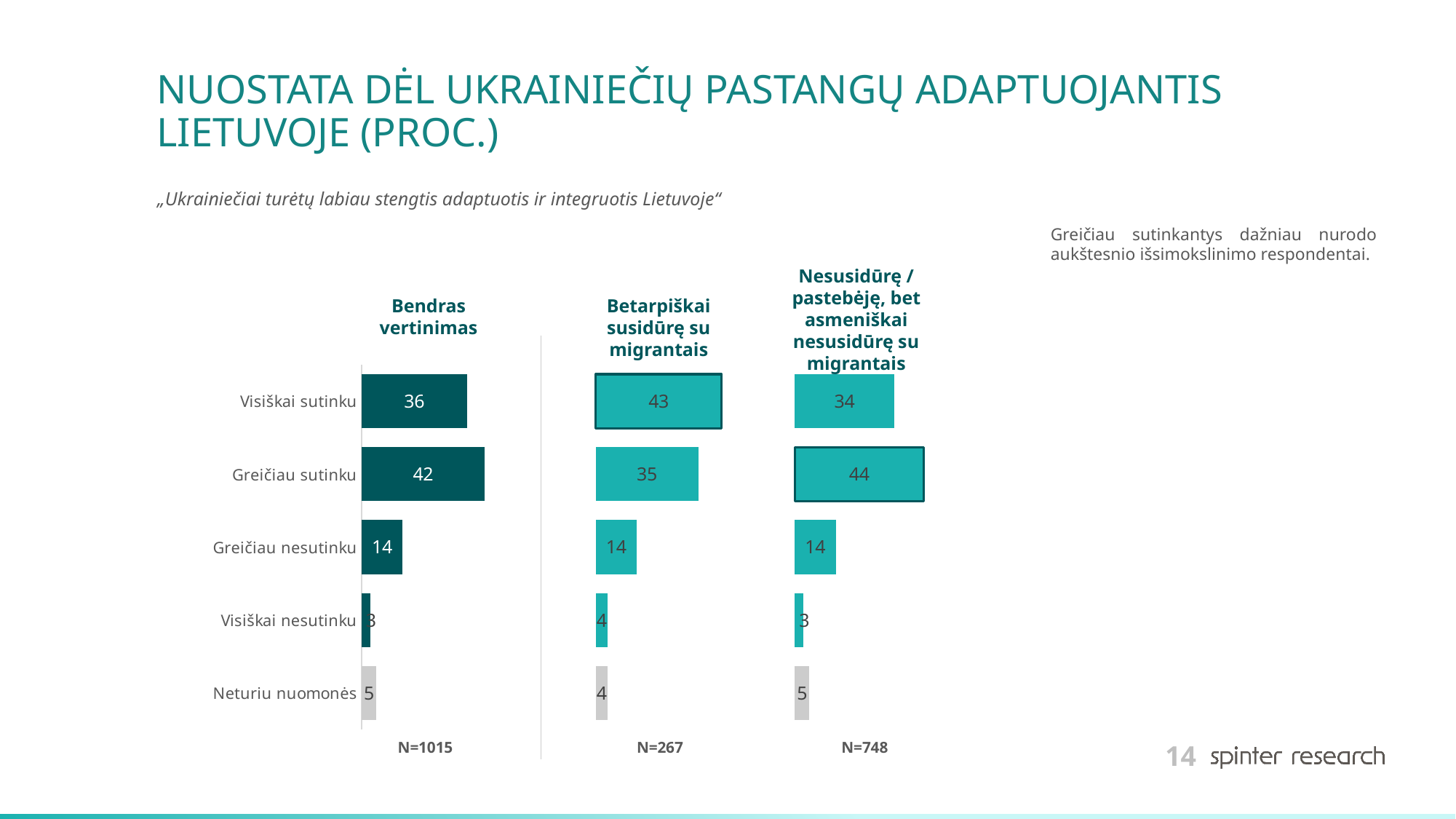
What is the sample size (N) shown under the "Betarpiškai susidūrę su migrantais" chart? N=267 Which is larger: "Visiškai sutinku" in the "Betarpiškai susidūrę su migrantais" chart or "Visiškai sutinku" in the "Nesusidūrę / pastebėję, bet asmeniškai nesusidūrę su migrantais" chart? Betarpiškai susidūrę su migrantais In the "Bendras vertinimas" chart, which category has the lowest value? Visiškai nesutinku In the "Nesusidūrę / pastebėję, bet asmeniškai nesusidūrę su migrantais" chart, what is the value for "Greičiau sutinku"? 44 In the "Bendras vertinimas" chart, what is the difference between "Greičiau sutinku" and "Visiškai sutinku"? 6 In the "Bendras vertinimas" chart, what is the value for "Greičiau sutinku"? 42 What type of chart is used on this slide? Bar chart In the "Betarpiškai susidūrę su migrantais" chart, what is the value for "Visiškai sutinku"? 43 In the "Nesusidūrę / pastebėję, bet asmeniškai nesusidūrę su migrantais" chart, what is the difference between "Greičiau sutinku" and "Visiškai sutinku"? 10 How many categories does the "Bendras vertinimas" chart show? 5 In the "Betarpiškai susidūrę su migrantais" chart, which category has the highest value? Visiškai sutinku In the "Bendras vertinimas" chart, which category has the highest value? Greičiau sutinku